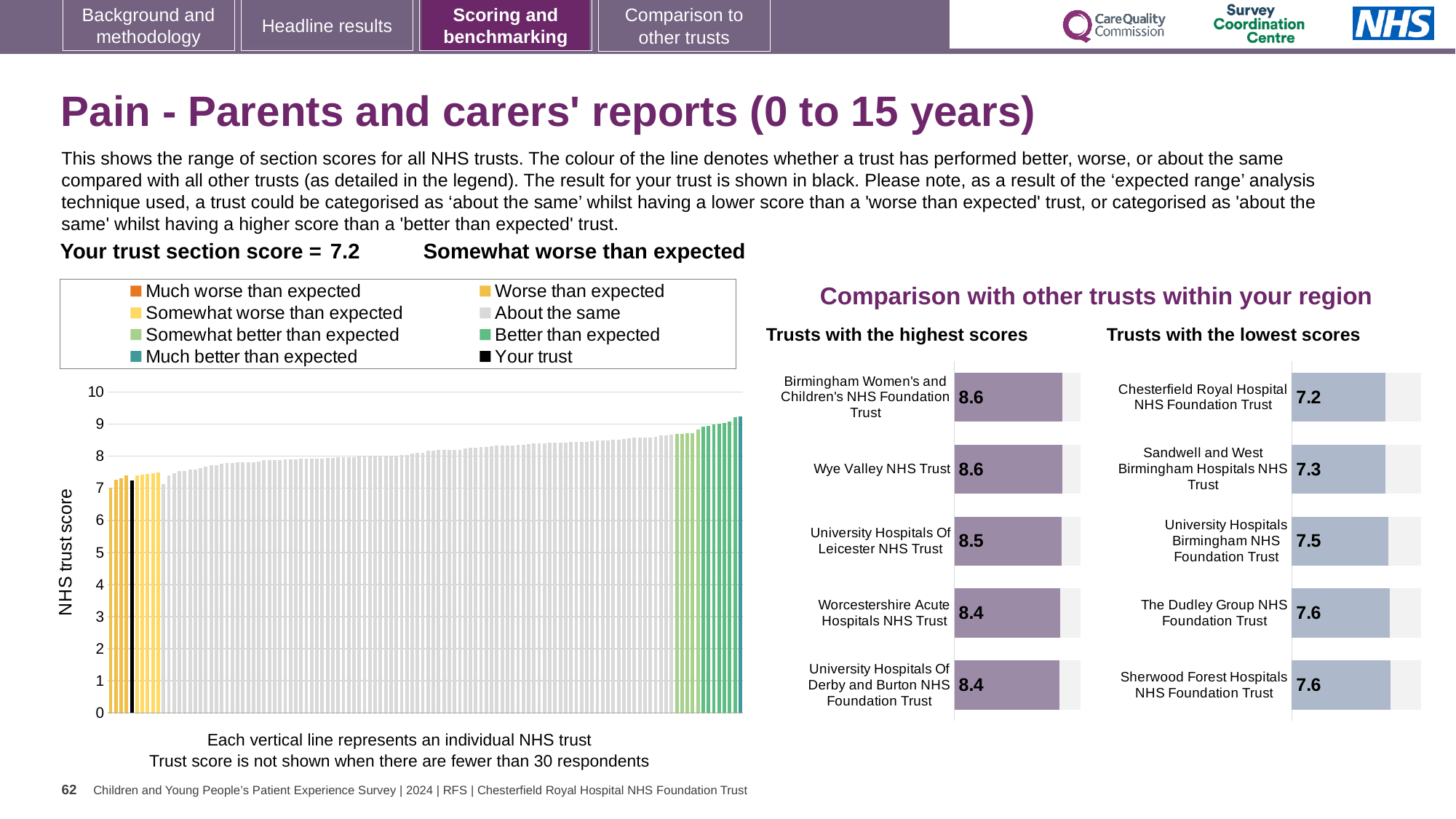
In the 'Trusts with the lowest scores' chart, which trust has the lowest score? Chesterfield Royal Hospital NHS Foundation Trust In the 'Trusts with the lowest scores' chart, what is the difference between the scores of Sherwood Forest Hospitals NHS Foundation Trust and Chesterfield Royal Hospital NHS Foundation Trust? 0.4 In the 'Trusts with the highest scores' chart, what is the difference between the scores of Birmingham Women's and Children's NHS Foundation Trust and Worcestershire Acute Hospitals NHS Trust? 0.2 In the 'Trusts with the highest scores' chart, what is the score for University Hospitals Of Leicester NHS Trust? 8.5 In the 'Trusts with the highest scores' chart, what is the score for Wye Valley NHS Trust? 8.6 What type of chart is the 'Trusts with the highest scores' chart? Bar chart In the 'Trusts with the highest scores' chart, which has the higher score: University Hospitals Of Leicester NHS Trust or University Hospitals Of Derby and Burton NHS Foundation Trust? University Hospitals Of Leicester NHS Trust What is the y-axis label of the main chart on the left? NHS trust score In the main chart on the left, do the trust scores rise or fall from left to right? Rise How many entries does the legend of the main chart on the left list? 8 How many trusts are shown in the 'Trusts with the lowest scores' chart? 5 In the 'Trusts with the lowest scores' chart, what is the score for Sandwell and West Birmingham Hospitals NHS Trust? 7.3